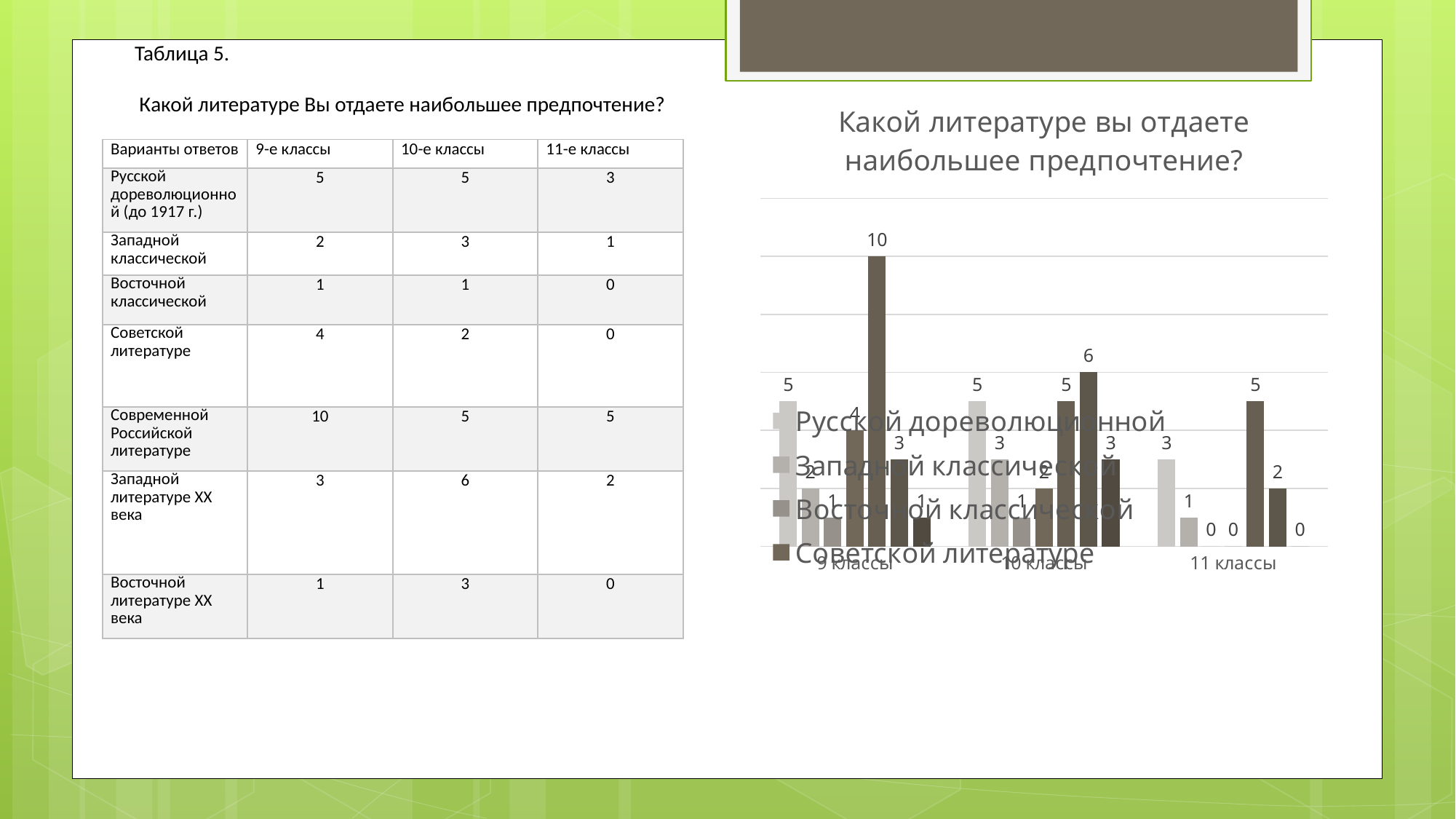
What is the value for Западной классической in the 10 классы group? 3 Which class group contains the tallest bar in the chart? 9 классы Do the values for Советской литературе rise or fall from 9 классы to 11 классы? fall What is the title of the chart? Какой литературе вы отдаете наибольшее предпочтение? What is the value of the tallest bar in the chart? 10 How many class groups (categories) are shown on the x axis of the chart? 3 What is the value for Советской литературе in the 9 классы group? 4 What is the value for Русской дореволюционной in the 9 классы group? 5 For Советской литературе, which group has the larger value: 9 классы or 10 классы? 9 классы What is the value for Русской дореволюционной in the 11 классы group? 3 What is the difference between the Русской дореволюционной values for 9 классы and 11 классы? 2 What kind of chart is shown on the slide? bar chart